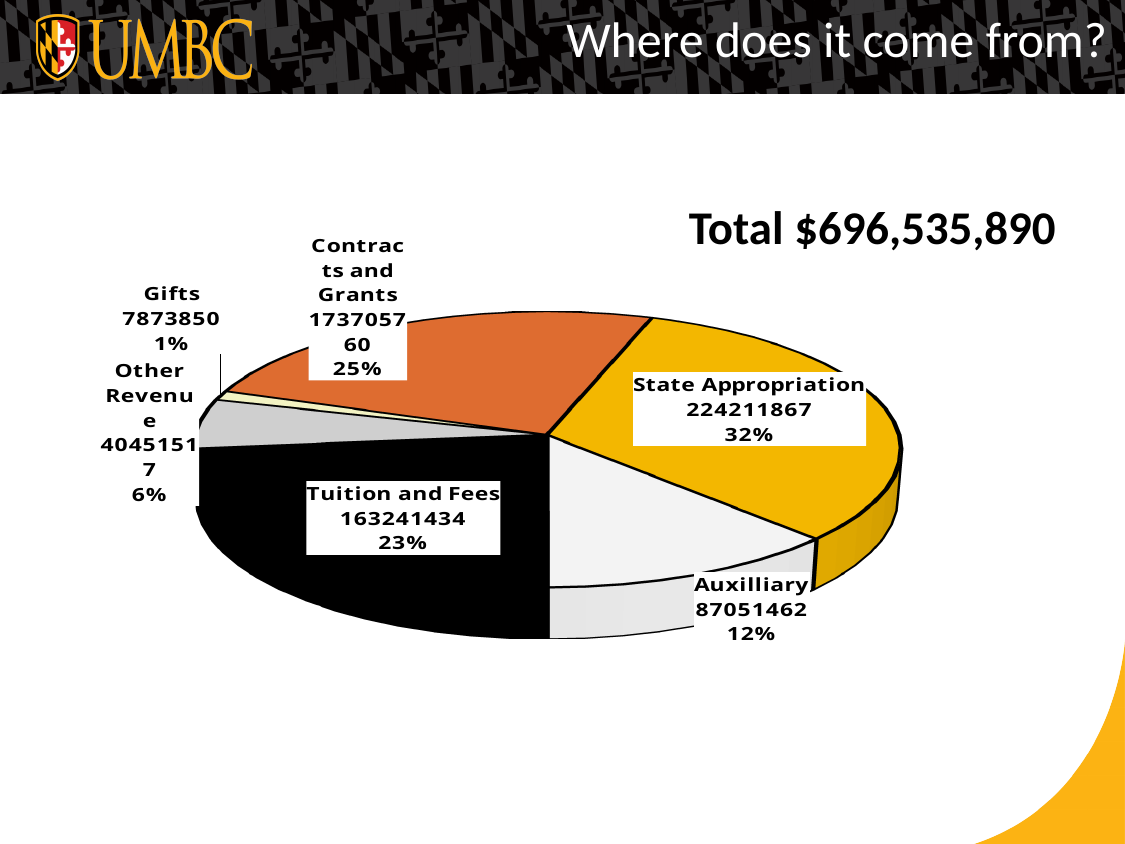
Which category has the smallest slice of the pie? Gifts How many slices does the pie chart have? 6 Which category has the largest slice of the pie? State Appropriation What is the value shown for Tuition and Fees? 163241434 What kind of chart is shown on the slide? Pie chart What is the value shown for Auxilliary? 87051462 What share of the pie does Contracts and Grants represent? 25% What share of the pie does State Appropriation represent? 32% What colour is the Tuition and Fees slice? Black What is the difference in percentage share between State Appropriation and Tuition and Fees? 9% Which is larger, Tuition and Fees or Auxilliary? Tuition and Fees What total amount is stated on the slide? $696,535,890